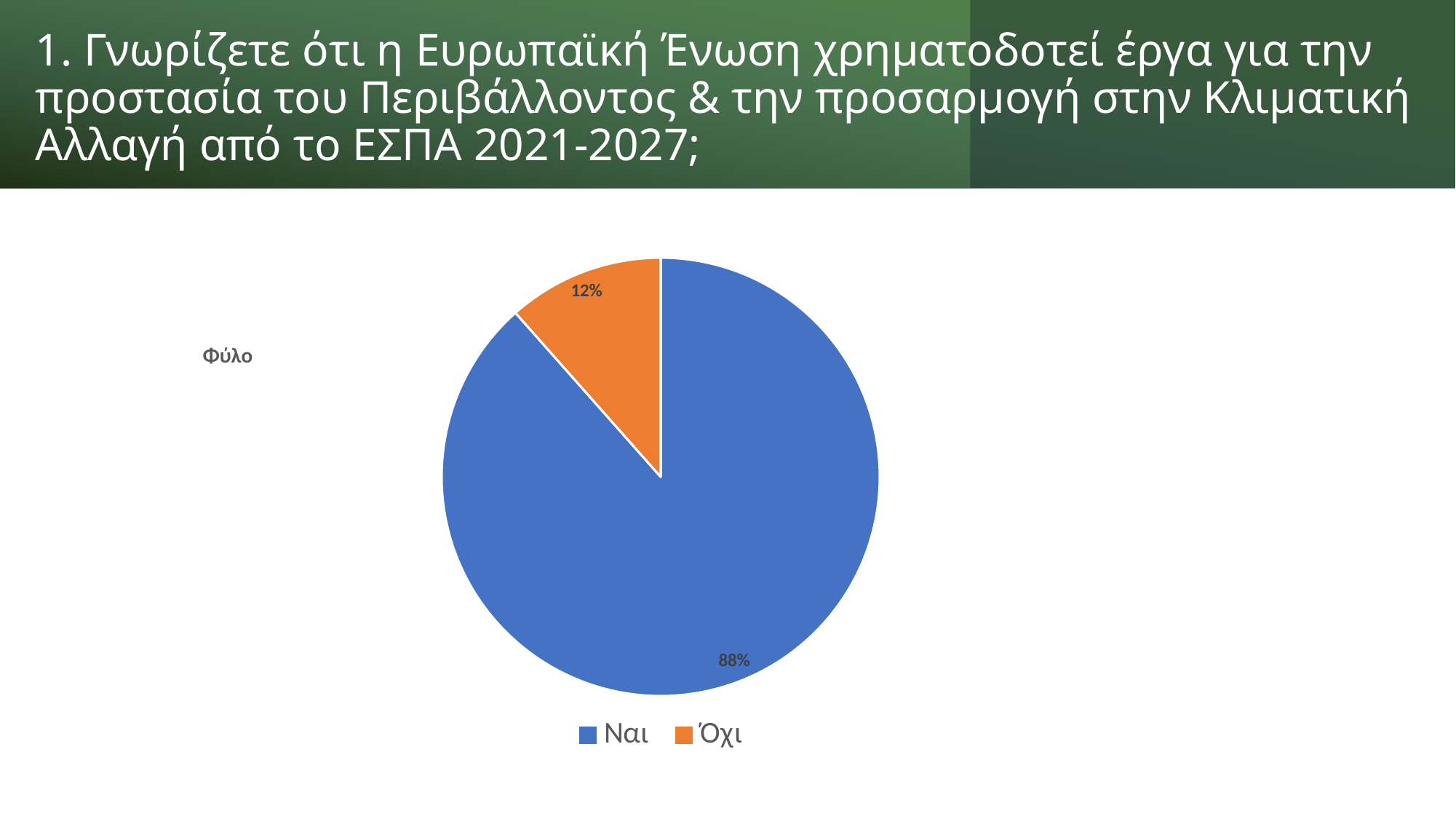
Which category has the smallest slice of the pie? Όχι What colour is the 'Όχι' slice? Orange How many entries does the legend list? 2 What is the difference in percentage points between the 'Ναι' and 'Όχι' slices? 76 What kind of chart is shown on the slide? Pie chart What share of the pie does the 'Ναι' slice represent? 88% Which is larger, the 'Ναι' slice or the 'Όχι' slice? Ναι What is the chart title shown to the left of the pie? Φύλο How many slices does the pie chart have? 2 What share of the pie does the 'Όχι' slice represent? 12% Which category has the largest slice of the pie? Ναι